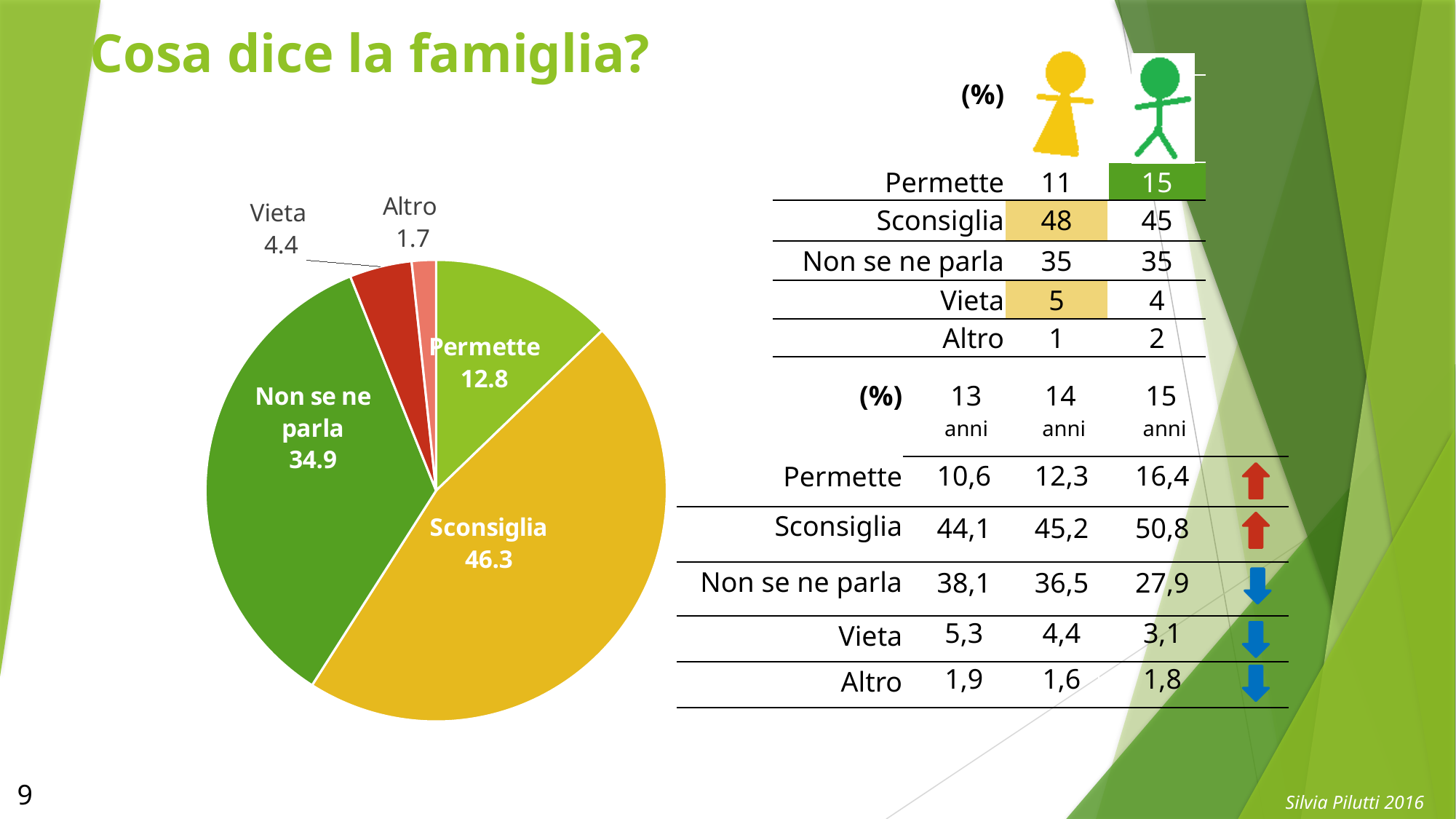
In the pie chart, what is the value for Vieta? 4.4 Which slice of the pie chart is the smallest? Altro What kind of chart is shown on the slide? pie chart Which slice of the pie chart is the largest? Sconsiglia In the pie chart, what is the value for Permette? 12.8 In the pie chart, what is the value for Non se ne parla? 34.9 In the pie chart, which is larger: Permette or Vieta? Permette What colour is the Sconsiglia slice in the pie chart? yellow In the pie chart, what is the difference between the values for Sconsiglia and Non se ne parla? 11.4 In the pie chart, what is the value for Altro? 1.7 How many slices does the pie chart have? 5 In the pie chart, what is the value for Sconsiglia? 46.3